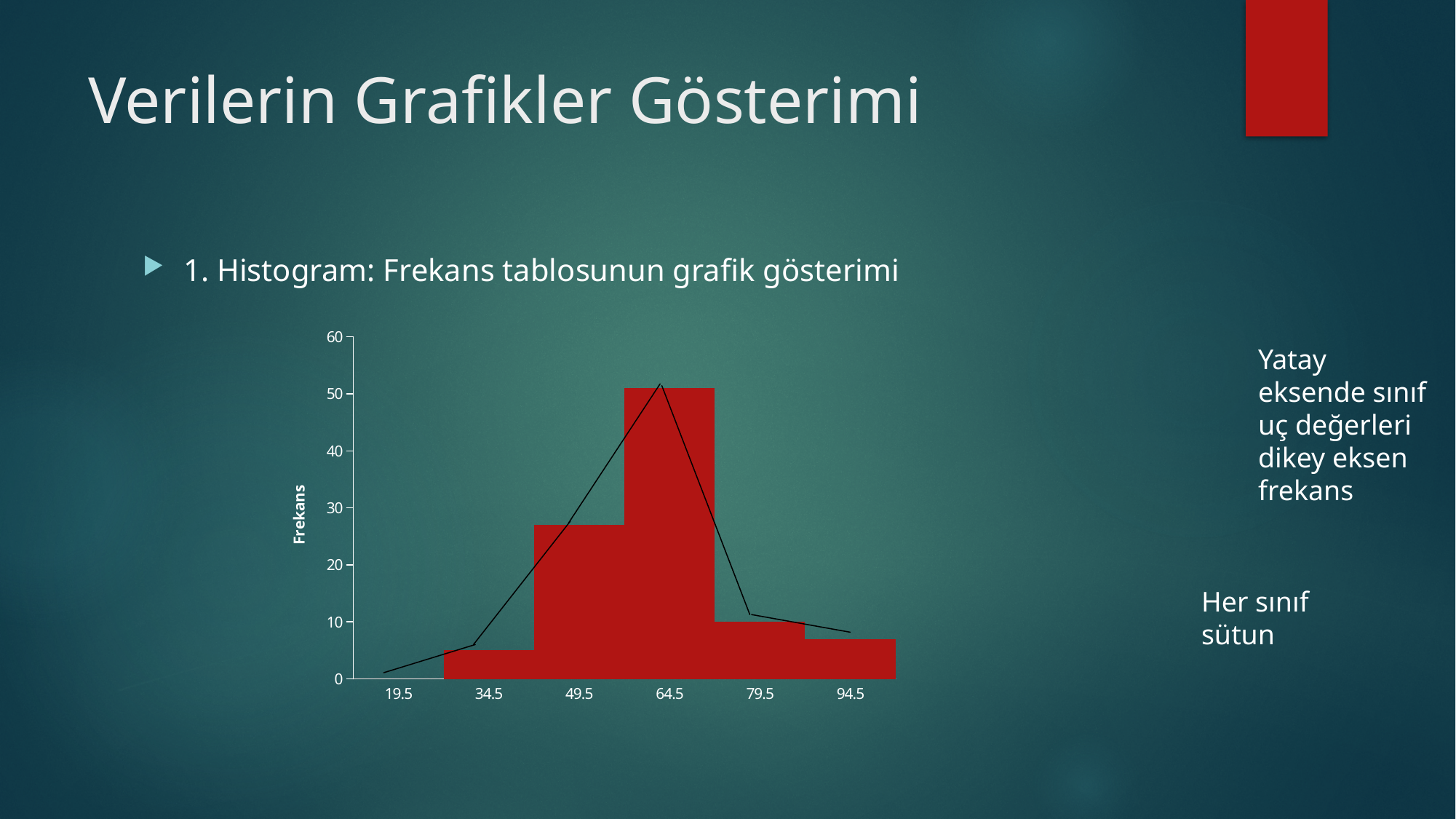
Which bar is taller, the one at 49.5 or the one at 79.5? 49.5 What colour are the bars in the histogram? red Is the frequency for the bar at 94.5 greater or less than 10? less What is the label of the vertical axis? Frekans Which x-axis class has the highest frequency? 64.5 Which bar is taller, the one at 64.5 or the one at 49.5? 64.5 Is the frequency for the bar at 64.5 greater or less than 40? greater Is the frequency for the bar at 49.5 greater or less than 20? greater What kind of chart is shown on the slide? bar chart (histogram) How many bars does the histogram have? 5